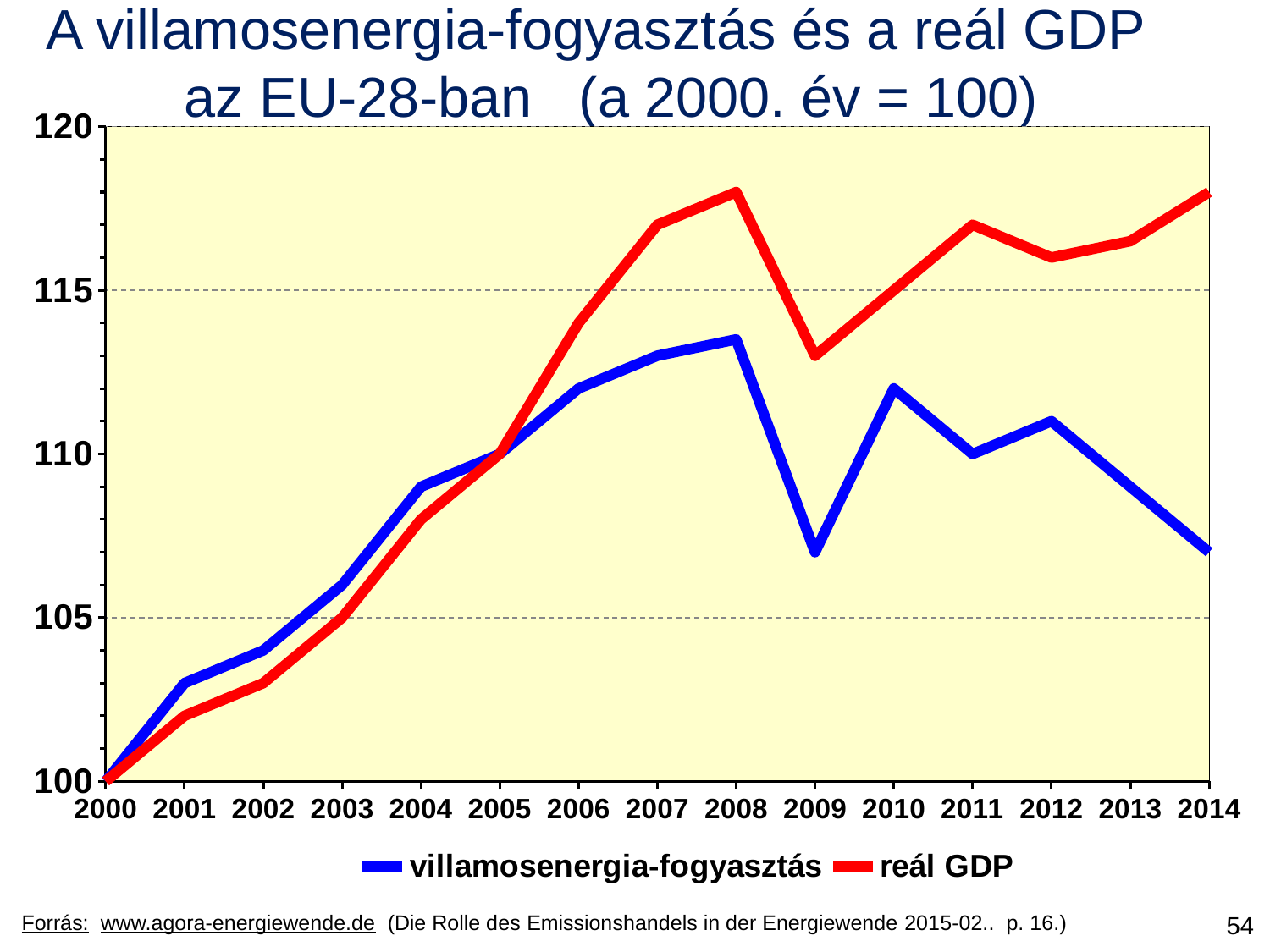
Is the value for reál GDP in 2009 greater or less than 115? less In 2003, which series has the higher value, villamosenergia-fogyasztás or reál GDP? villamosenergia-fogyasztás Is the value for villamosenergia-fogyasztás in 2014 greater or less than 110? less How many years are plotted along the x axis? 15 What kind of chart is shown on the slide? line chart What is the value of reál GDP in 2000? 100 Does the villamosenergia-fogyasztás series rise or fall from 2000 to 2008? rise Is the value for villamosenergia-fogyasztás in 2009 greater or less than 110? less Which colour is used for the reál GDP line? red How many series does the legend list? 2 In 2014, which series has the higher value, villamosenergia-fogyasztás or reál GDP? reál GDP